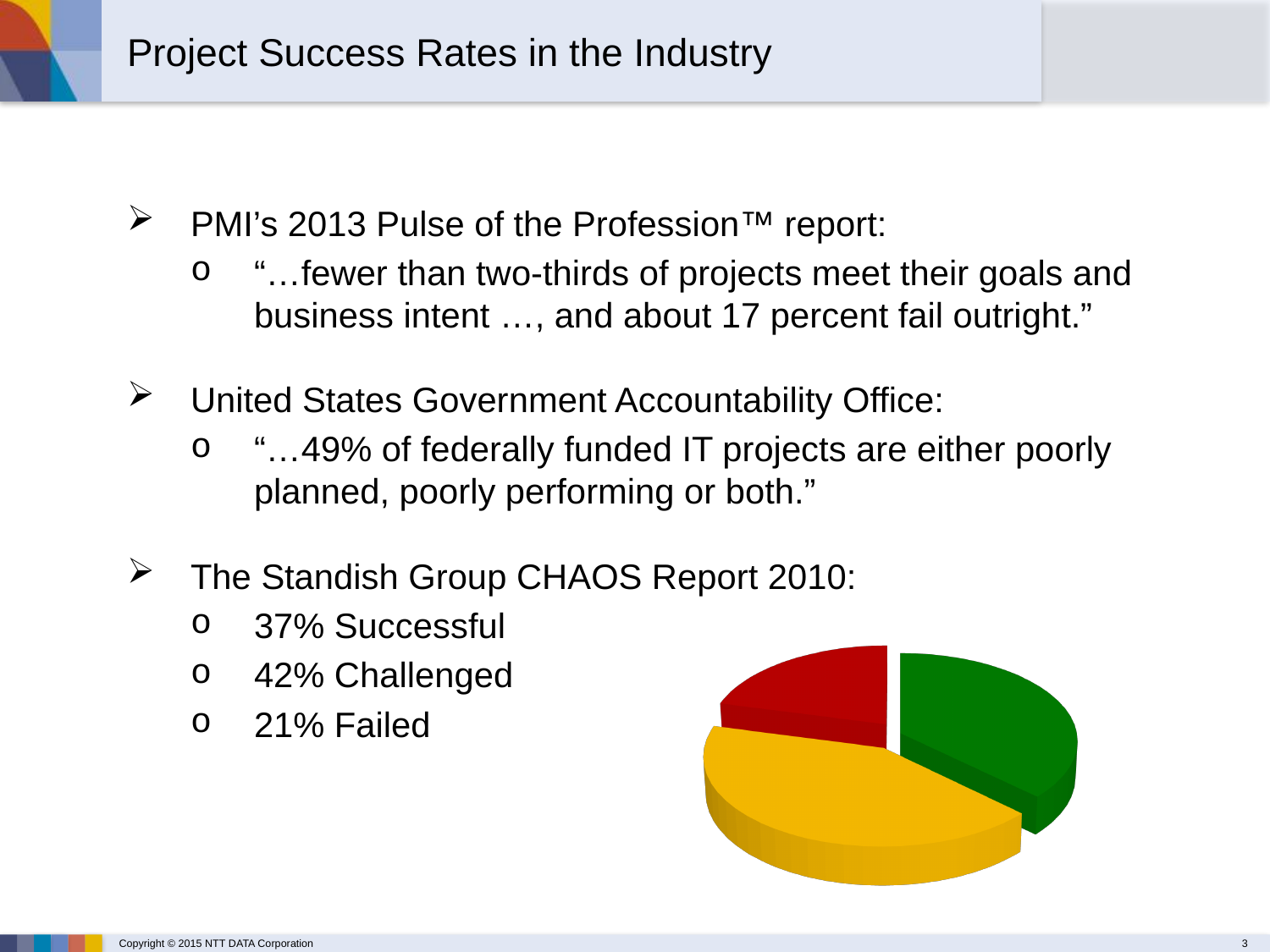
Which slice of the pie chart is the largest? the yellow slice What kind of chart is shown on the slide? pie chart Does the pie chart have a legend? No Which slice of the pie chart is the smallest? the red slice Which slice of the pie chart is larger, the green slice or the red slice? the green slice How many slices does the pie chart have? 3 Which slice of the pie chart is larger, the yellow slice or the green slice? the yellow slice What colours are the slices of the pie chart? green, yellow and red